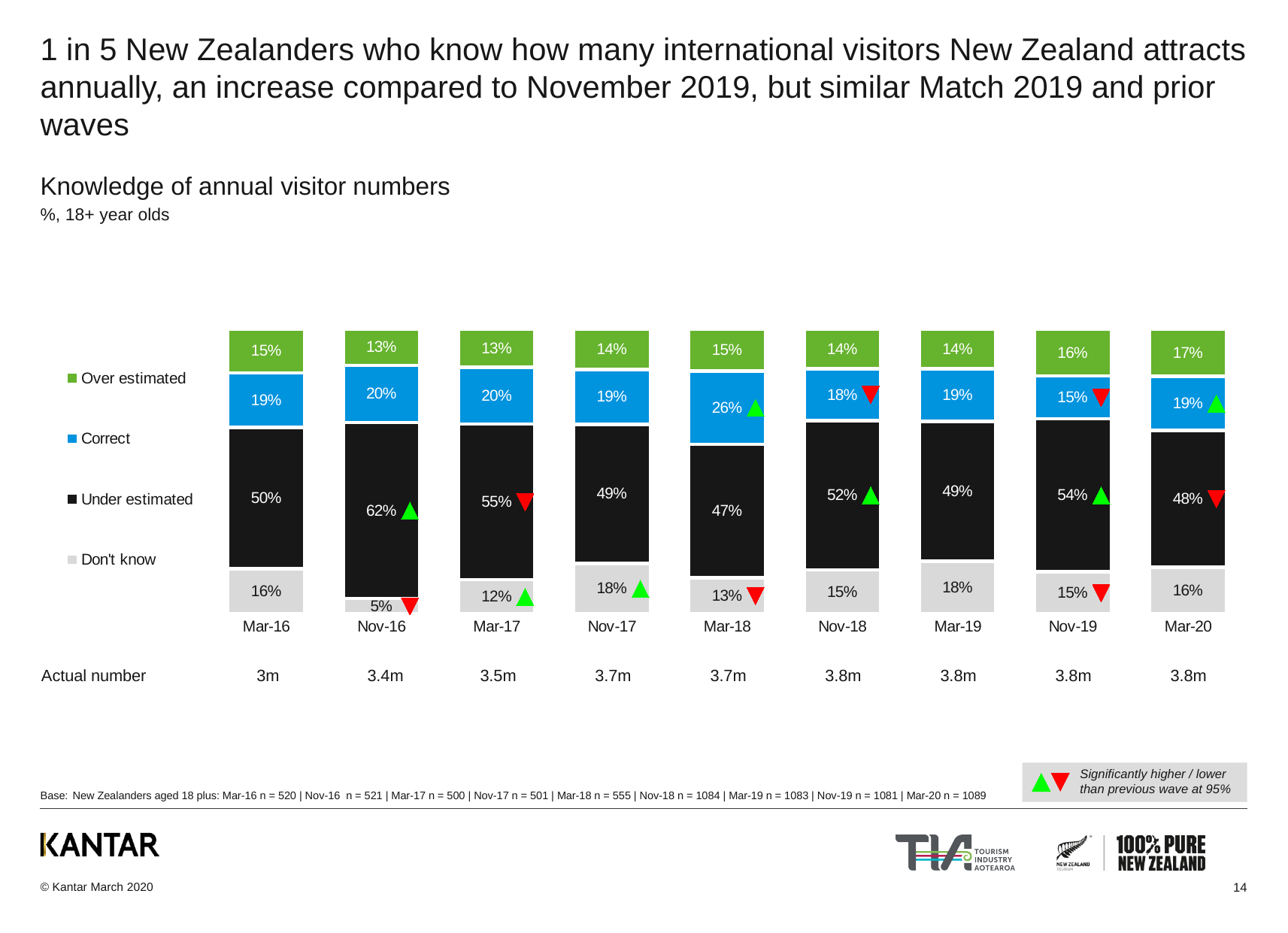
What percentage of respondents gave the correct answer in Mar-18? 26% How many series does the legend list? 4 What is the total of the Mar-16 stacked bar? 100% In which wave is the 'Under estimated' share highest? Nov-16 What is the 'Don't know' value for Mar-20? 16% What is the 'Under estimated' value for Nov-16? 62% What is the 'Over estimated' value for Nov-19? 16% In which wave is the 'Don't know' share lowest? Nov-16 Which is larger: the 'Correct' share in Nov-19 or in Mar-20? Mar-20 By how many percentage points did the 'Correct' share fall from Mar-18 to Nov-18? 8 percentage points How many survey waves are shown on the x axis? 9 What kind of chart is shown on the slide? Stacked bar chart